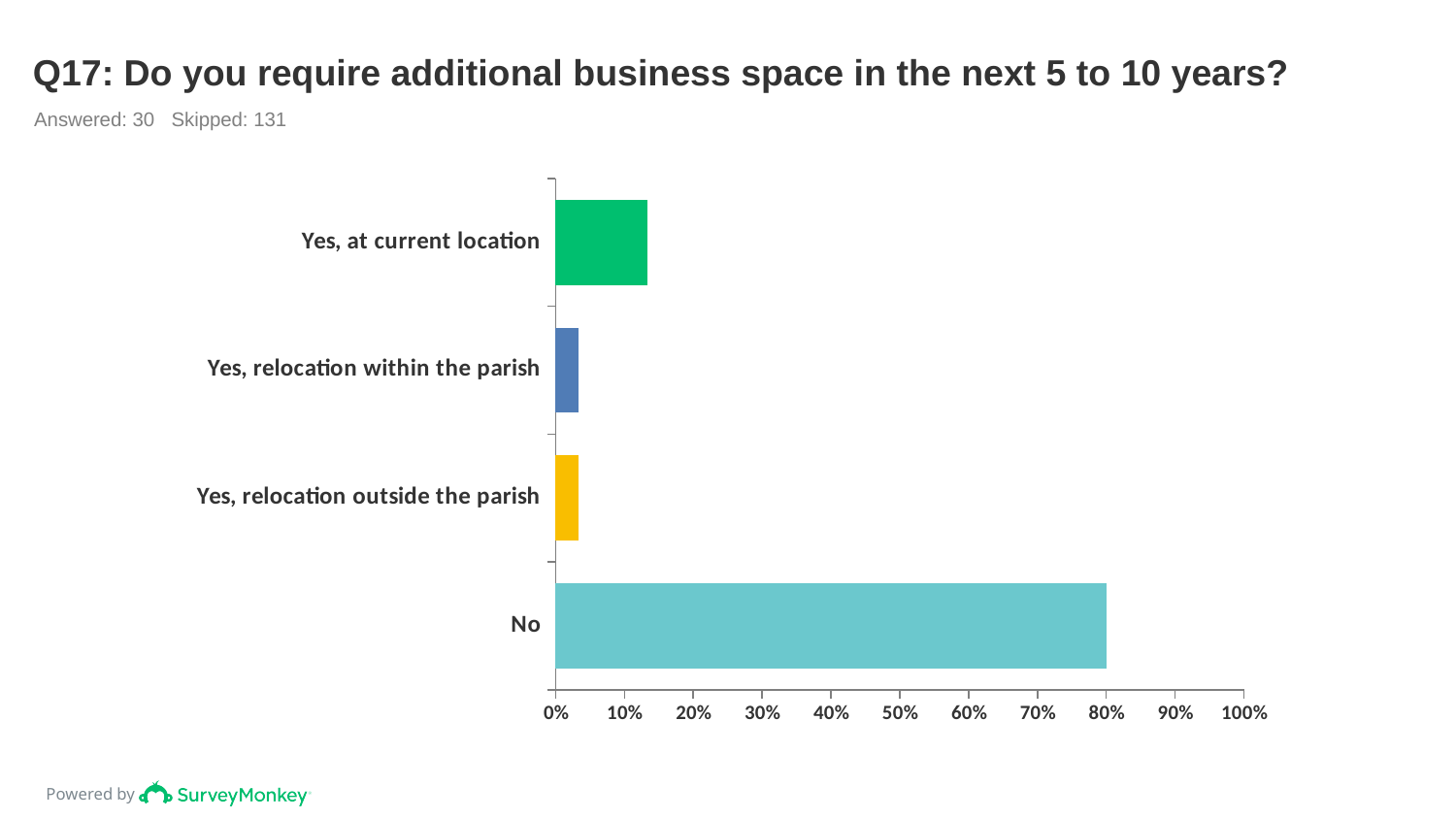
Is the value for "Yes, at current location" greater or less than 20%? less Which is larger, the value for "Yes, at current location" or the value for "Yes, relocation within the parish"? Yes, at current location Is the value for "Yes, relocation outside the parish" greater or less than 10%? less Is the value for "Yes, at current location" greater or less than 10%? greater What kind of chart is shown on the slide? bar chart What is the value for "No"? 80% How many respondents answered this question according to the slide? 30 Which is larger, the value for "No" or the value for "Yes, at current location"? No Which response category has the highest value? No What is the title of the chart? Q17: Do you require additional business space in the next 5 to 10 years? How many response categories are shown in the chart? 4